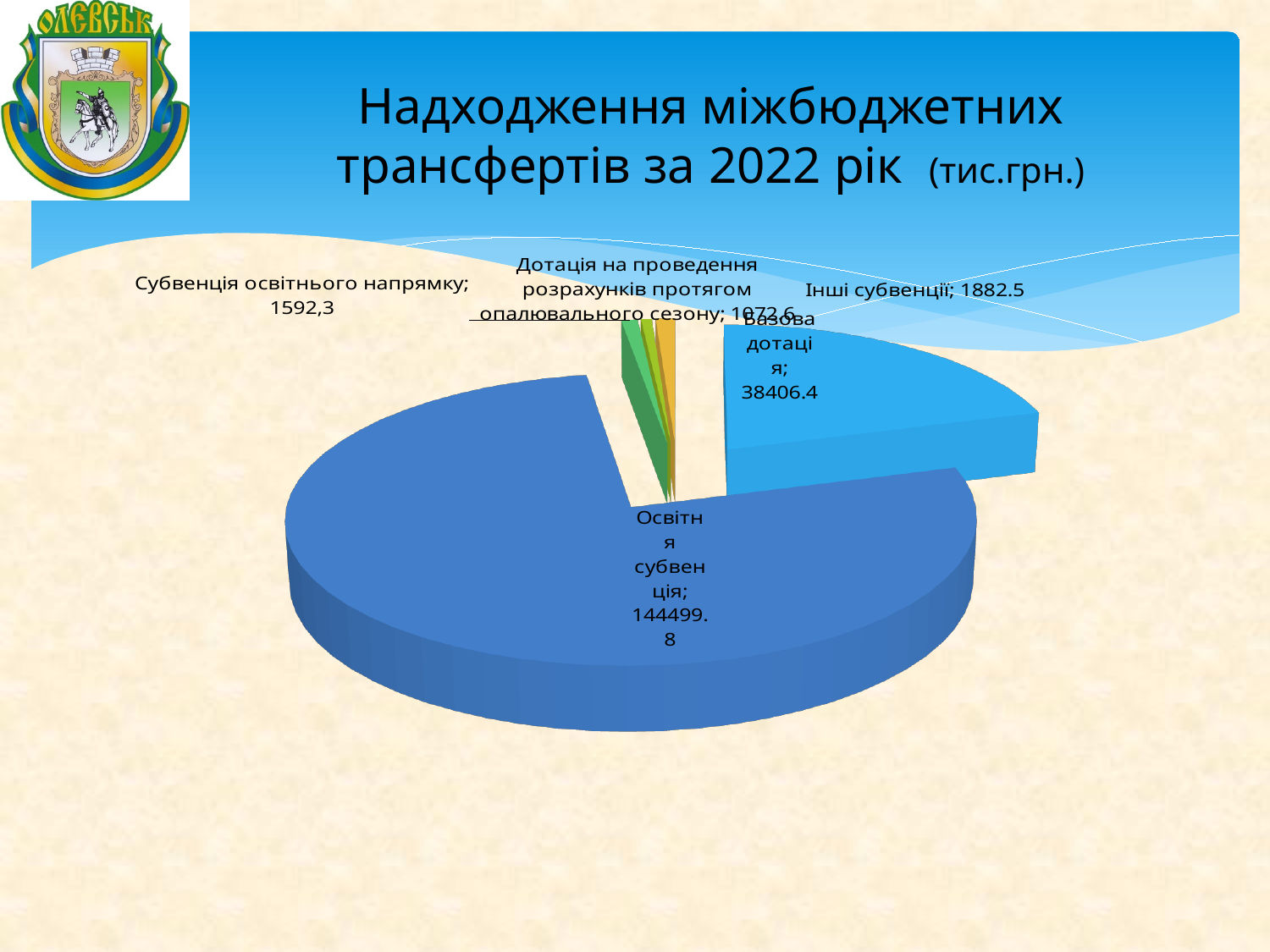
What is the title of the chart? Надходження міжбюджетних трансфертів за 2022 рік (тис.грн.) Which category has the largest slice of the pie? Освітня субвенція What is the difference between the values for Освітня субвенція and Базова дотація? 106093.4 What is the value for Базова дотація? 38406.4 What kind of chart is shown on the slide? Pie chart What is the difference between the values for Інші субвенції and Субвенція освітнього напрямку? 290.2 What is the value for Інші субвенції? 1882.5 How many slices does the pie chart have? 5 What is the value for Освітня субвенція? 144499.8 Which category has the smallest slice of the pie? Дотація на проведення розрахунків протягом опалювального сезону What is the value for Субвенція освітнього напрямку? 1592,3 Which is larger, the value for Базова дотація or the value for Інші субвенції? Базова дотація